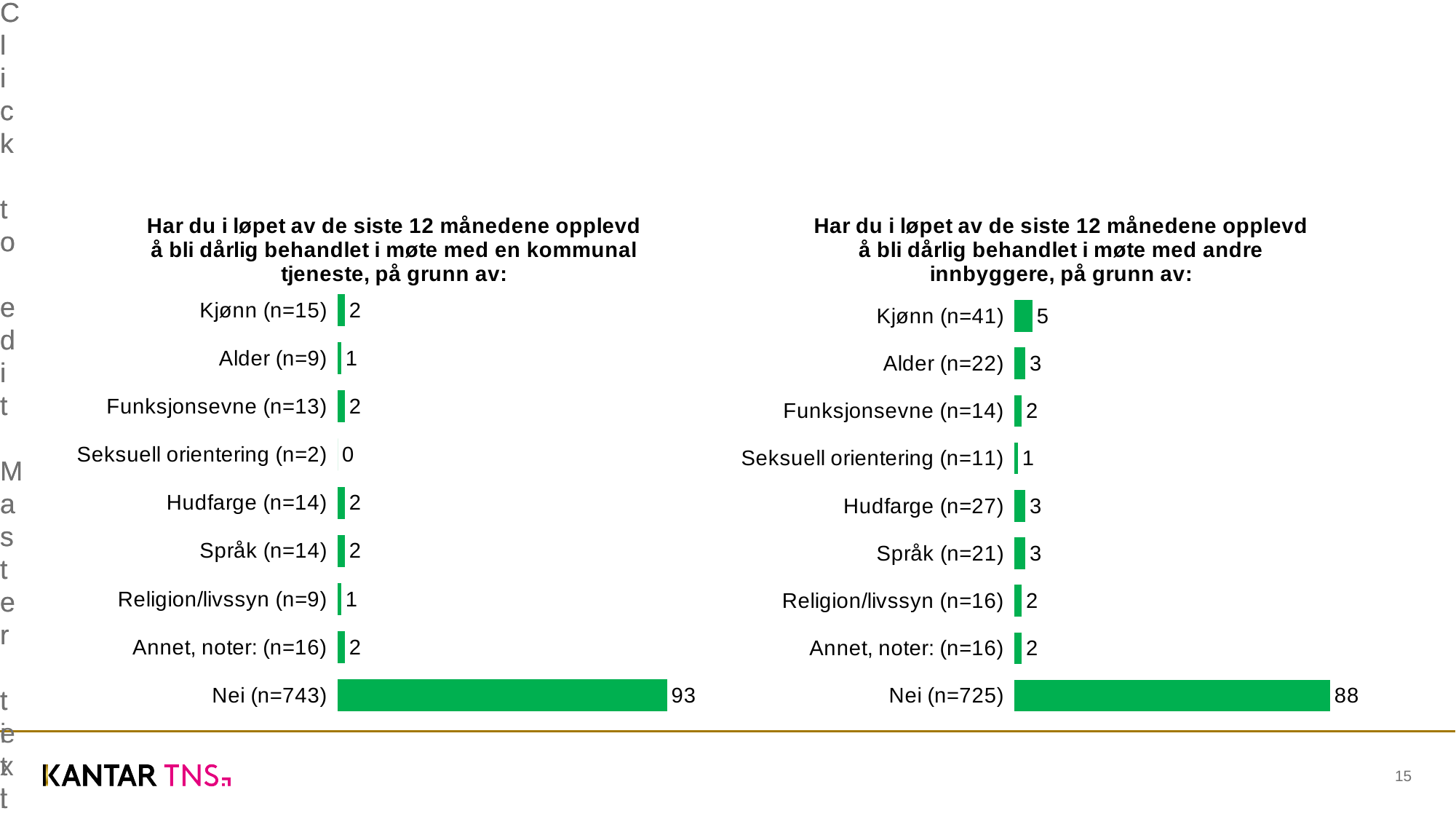
In the left chart (kommunal tjeneste), what is the value for Seksuell orientering (n=2)? 0 In the left chart (kommunal tjeneste), what is the value for Nei (n=743)? 93 In the right chart (andre innbyggere), which is larger: the value for Kjønn (n=41) or the value for Alder (n=22)? Kjønn (n=41) What kind of chart is the right chart (andre innbyggere)? Bar chart In the right chart (andre innbyggere), what is the value for Hudfarge (n=27)? 3 In the right chart (andre innbyggere), what is the value for Kjønn (n=41)? 5 What colour are the bars in both charts? Green What is the difference between the Nei value in the left chart (93) and the Nei value in the right chart (88)? 5 In the right chart (andre innbyggere), what is the difference between the values for Kjønn (n=41) and Seksuell orientering (n=11)? 4 How many categories are shown in the left chart (kommunal tjeneste)? 9 In the left chart (kommunal tjeneste), which category has the lowest value? Seksuell orientering (n=2) In the right chart (andre innbyggere), which category has the highest value? Nei (n=725)